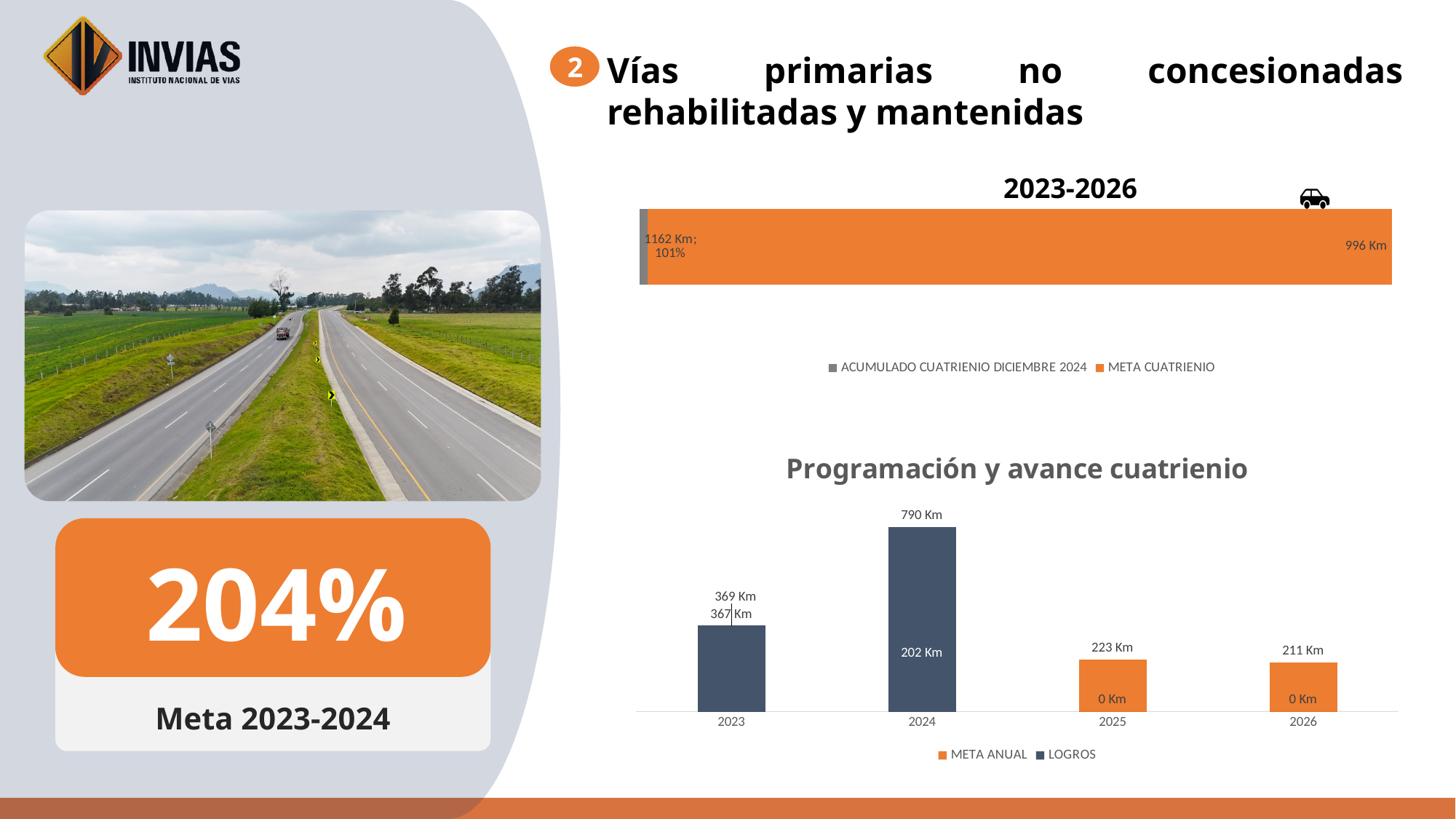
In the 'Programación y avance cuatrienio' chart, what is the difference between the META ANUAL for 2025 and for 2026? 12 Km In the 'Programación y avance cuatrienio' chart, which year has the tallest bar? 2024 What kind of chart is 'Programación y avance cuatrienio'? Bar chart In the '2023-2026' chart, what value is shown for ACUMULADO CUATRIENIO DICIEMBRE 2024? 1162 Km; 101% In the 'Programación y avance cuatrienio' chart, what is the META ANUAL for 2025? 223 Km In the 'Programación y avance cuatrienio' chart, what is the LOGROS value for 2026? 0 Km In the 'Programación y avance cuatrienio' chart, what is the META ANUAL for 2026? 211 Km In the '2023-2026' chart, what is the difference in Km between the ACUMULADO CUATRIENIO DICIEMBRE 2024 value and the META CUATRIENIO value? 166 Km In the '2023-2026' chart, how many series does the legend list? 2 In the '2023-2026' chart, what is the value for META CUATRIENIO? 996 Km In the 'Programación y avance cuatrienio' chart, how many years are shown on the x axis? 4 In the 'Programación y avance cuatrienio' chart, what is the highest value labelled on any bar? 790 Km